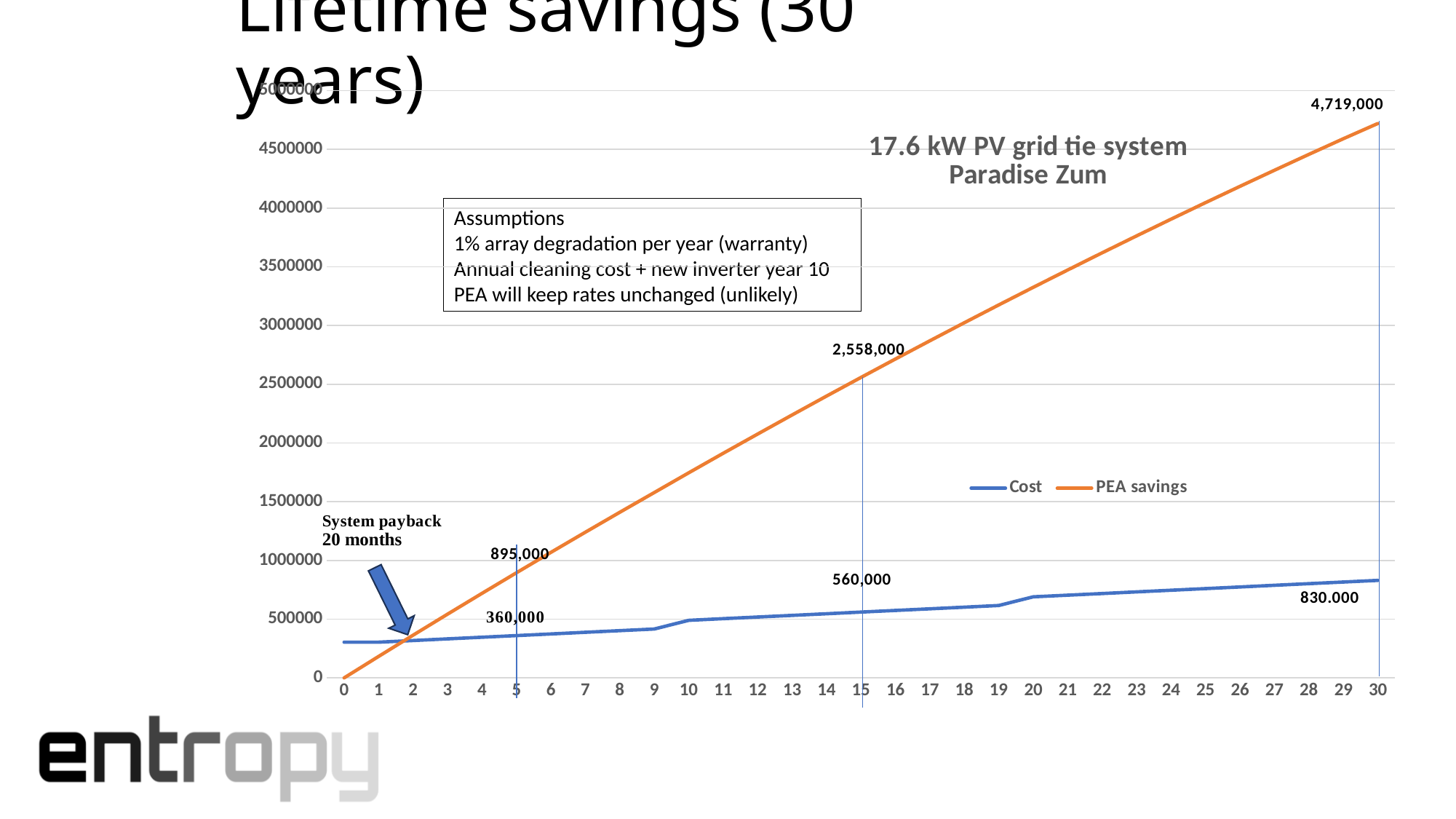
Does the PEA savings line rise or fall as the years increase? Rises What is the PEA savings value at year 5? 895,000 What is the PEA savings value at year 15? 2,558,000 What type of chart is shown on the slide? Line chart What is the Cost value at year 15? 560,000 What is the Cost value at year 5? 360,000 What is the difference between PEA savings and Cost at year 15? 1,998,000 What is the PEA savings value at year 30? 4,719,000 Is the Cost value at year 20 greater or less than 1000000? less Which series is higher at year 30, Cost or PEA savings? PEA savings What is the difference between PEA savings and Cost at year 5? 535,000 How many series does the chart legend list? 2